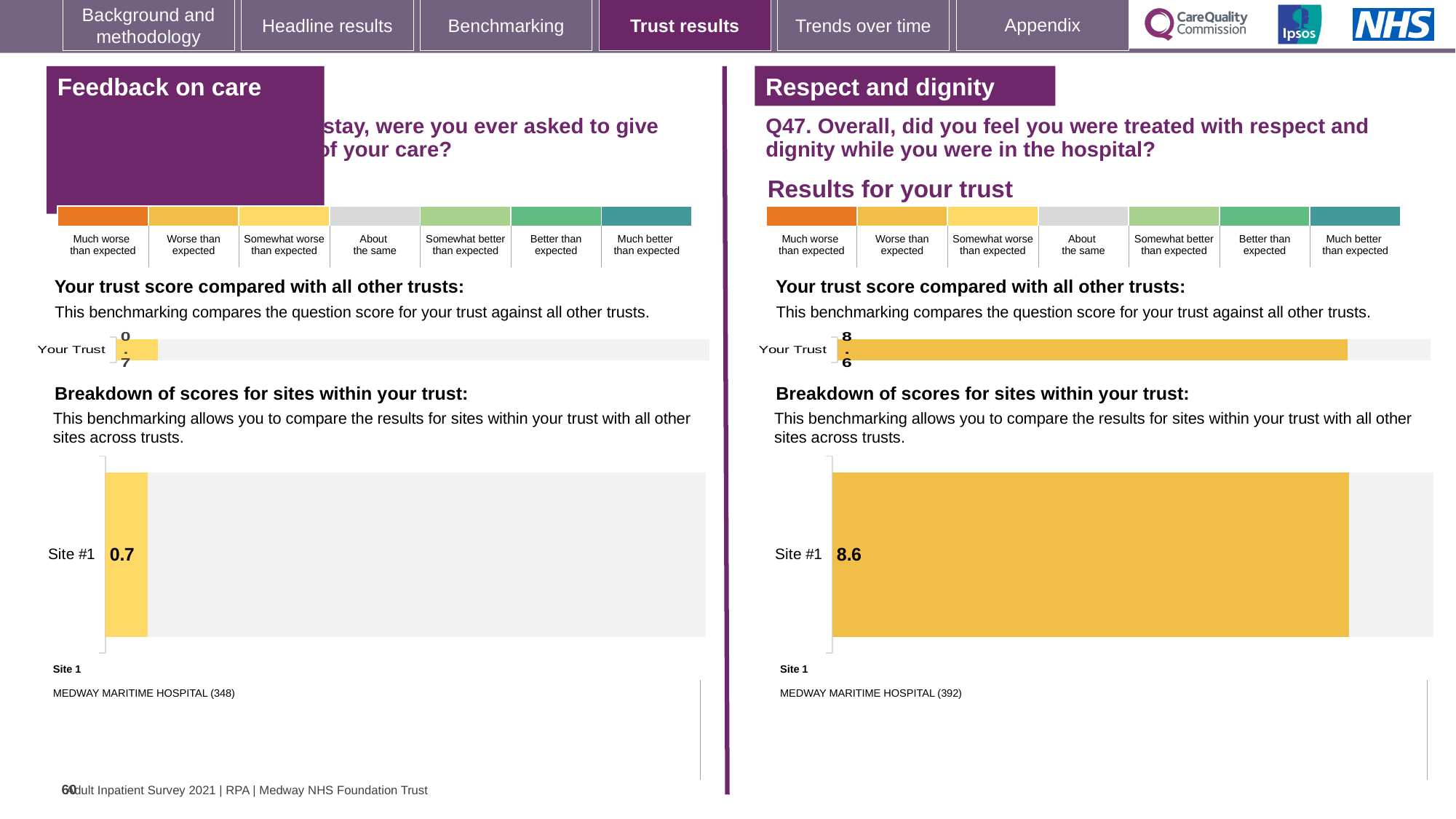
What kind of chart is used to show the Site #1 score in the Respect and dignity 'Breakdown of scores for sites within your trust' section? Bar chart Which site is listed as Site 1 below the Respect and dignity breakdown chart? MEDWAY MARITIME HOSPITAL (392) How many sites are plotted in the Respect and dignity 'Breakdown of scores for sites within your trust' chart? 1 How many sites are plotted in the Feedback on care 'Breakdown of scores for sites within your trust' chart? 1 On the Feedback on care section, what score is shown for Site #1 in the 'Breakdown of scores for sites within your trust' chart? 0.7 On the Respect and dignity section, what is the value shown for Your Trust in the 'Your trust score compared with all other trusts' chart? 8.6 On the Respect and dignity section, what score is shown for Site #1 in the 'Breakdown of scores for sites within your trust' chart? 8.6 What is the difference between the Site #1 score in the Respect and dignity breakdown chart and the Site #1 score in the Feedback on care breakdown chart? 7.9 Which is larger: the Site #1 score in the Feedback on care breakdown chart or the Site #1 score in the Respect and dignity breakdown chart? Respect and dignity Is the Your Trust score in the Respect and dignity section greater or less than the Your Trust score in the Feedback on care section? greater Which site is listed as Site 1 below the Feedback on care breakdown chart? MEDWAY MARITIME HOSPITAL (348) On the Feedback on care section, what is the value shown for Your Trust in the 'Your trust score compared with all other trusts' chart? 0.7